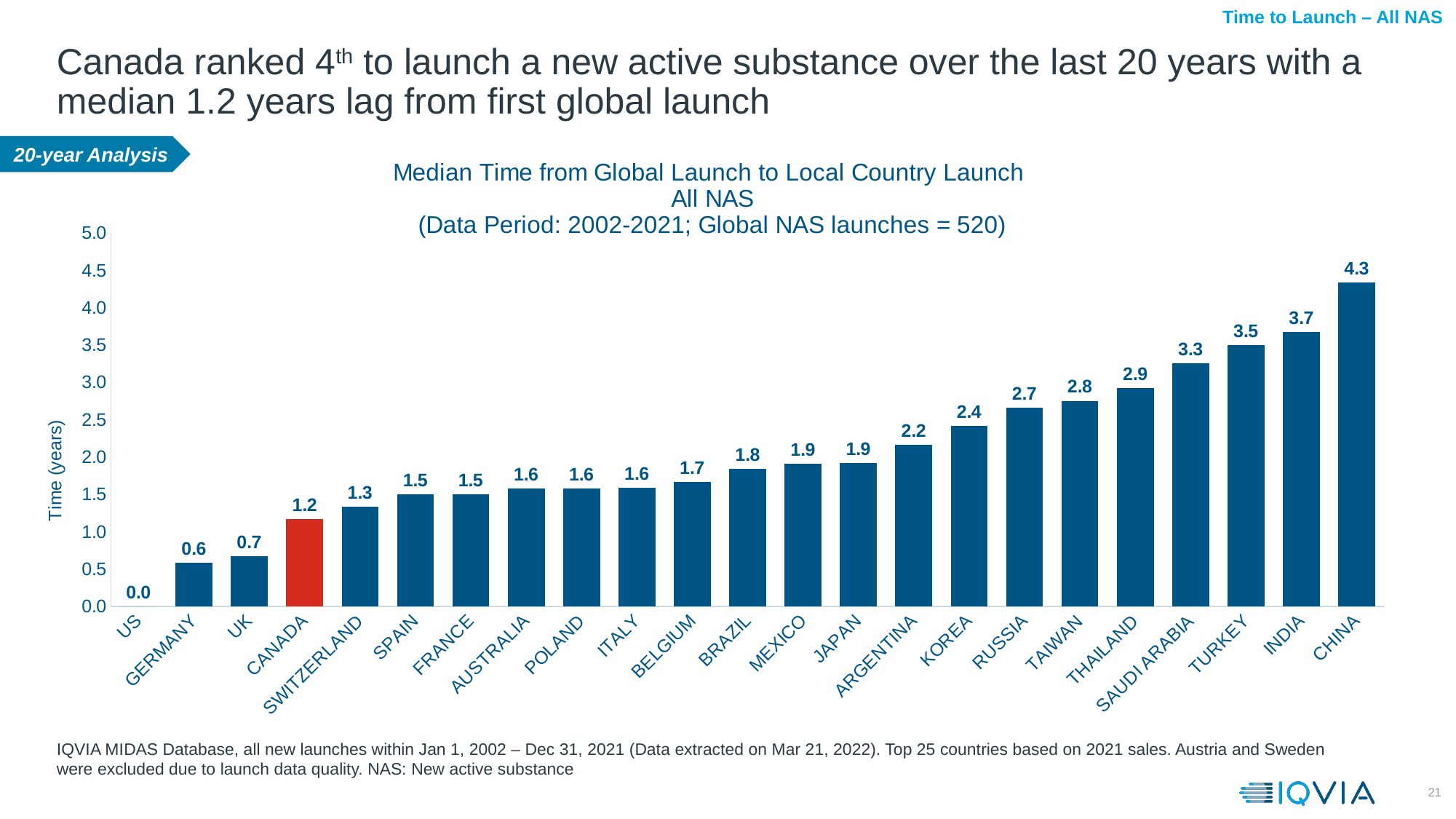
What is the value shown for Japan? 1.9 How many countries are shown on the chart? 23 Which has a larger value, Turkey or Korea? Turkey Which country's bar is highlighted in red? Canada Which country has the highest median time to launch? China Is the value for Thailand greater or less than 3.0? less What is the difference between the values for Canada and Germany? 0.6 Which country has the lowest median time to launch? US What is the median time from global launch to local launch for Canada? 1.2 What type of chart is shown on the slide? Bar chart What is the value shown for Saudi Arabia? 3.3 What is the difference between the values for China and India? 0.6